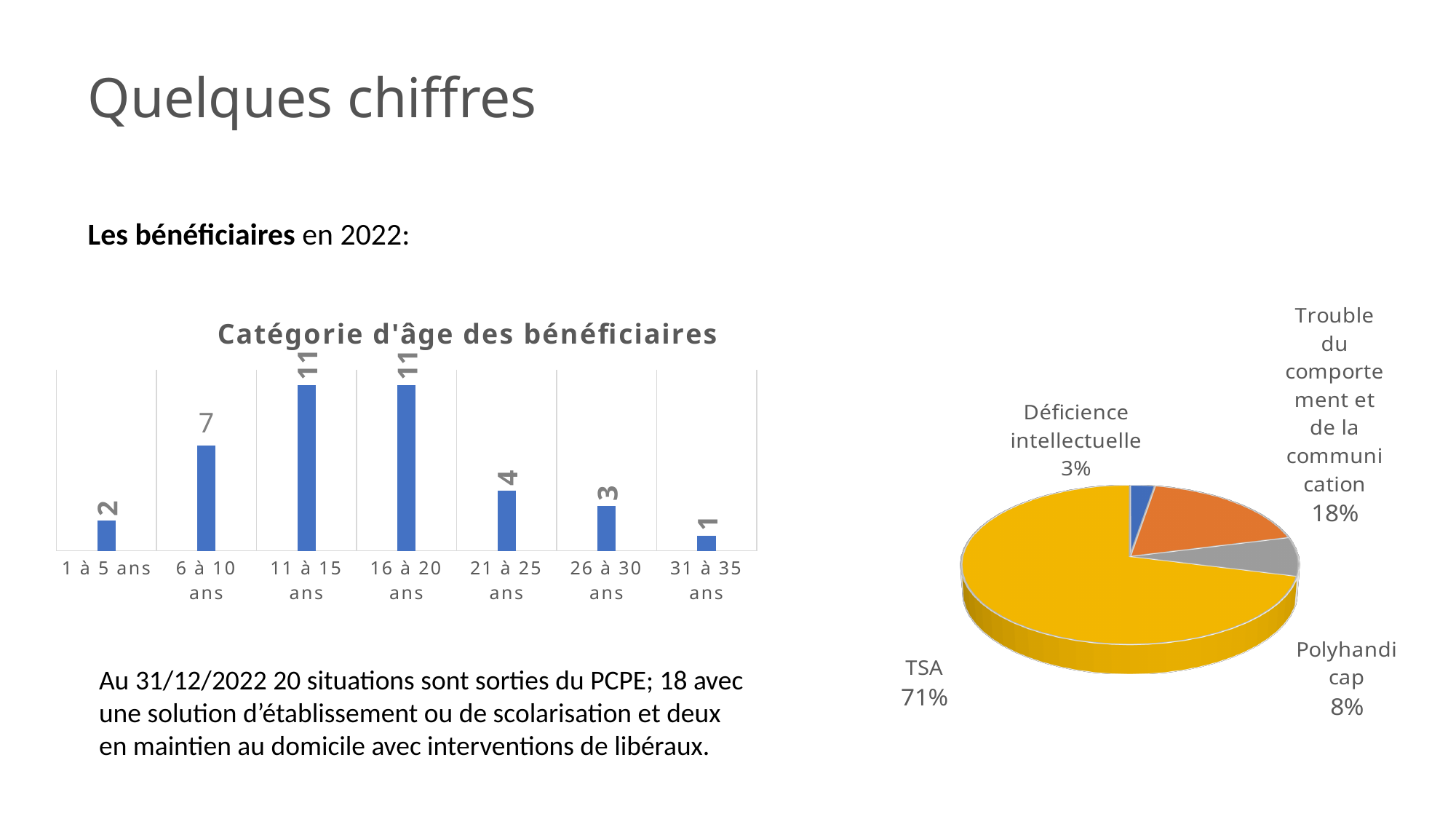
What kind of chart is the chart on the right of the slide? pie chart In the 'Catégorie d'âge des bénéficiaires' chart, which is larger: the value for '1 à 5 ans' or '26 à 30 ans'? 26 à 30 ans In the pie chart on the right, which slice is the smallest? Déficience intellectuelle In the 'Catégorie d'âge des bénéficiaires' chart, what is the value for '6 à 10 ans'? 7 In the 'Catégorie d'âge des bénéficiaires' chart, which age category has the lowest value? 31 à 35 ans In the 'Catégorie d'âge des bénéficiaires' chart, what is the difference between the values for '11 à 15 ans' and '26 à 30 ans'? 8 In the pie chart on the right, what share does 'TSA' have? 71% How many age categories are shown in the 'Catégorie d'âge des bénéficiaires' chart? 7 In the 'Catégorie d'âge des bénéficiaires' chart, what is the value for '21 à 25 ans'? 4 How many slices does the pie chart on the right have? 4 What kind of chart is the 'Catégorie d'âge des bénéficiaires' chart? bar chart In the pie chart on the right, what share does 'Polyhandicap' have? 8%